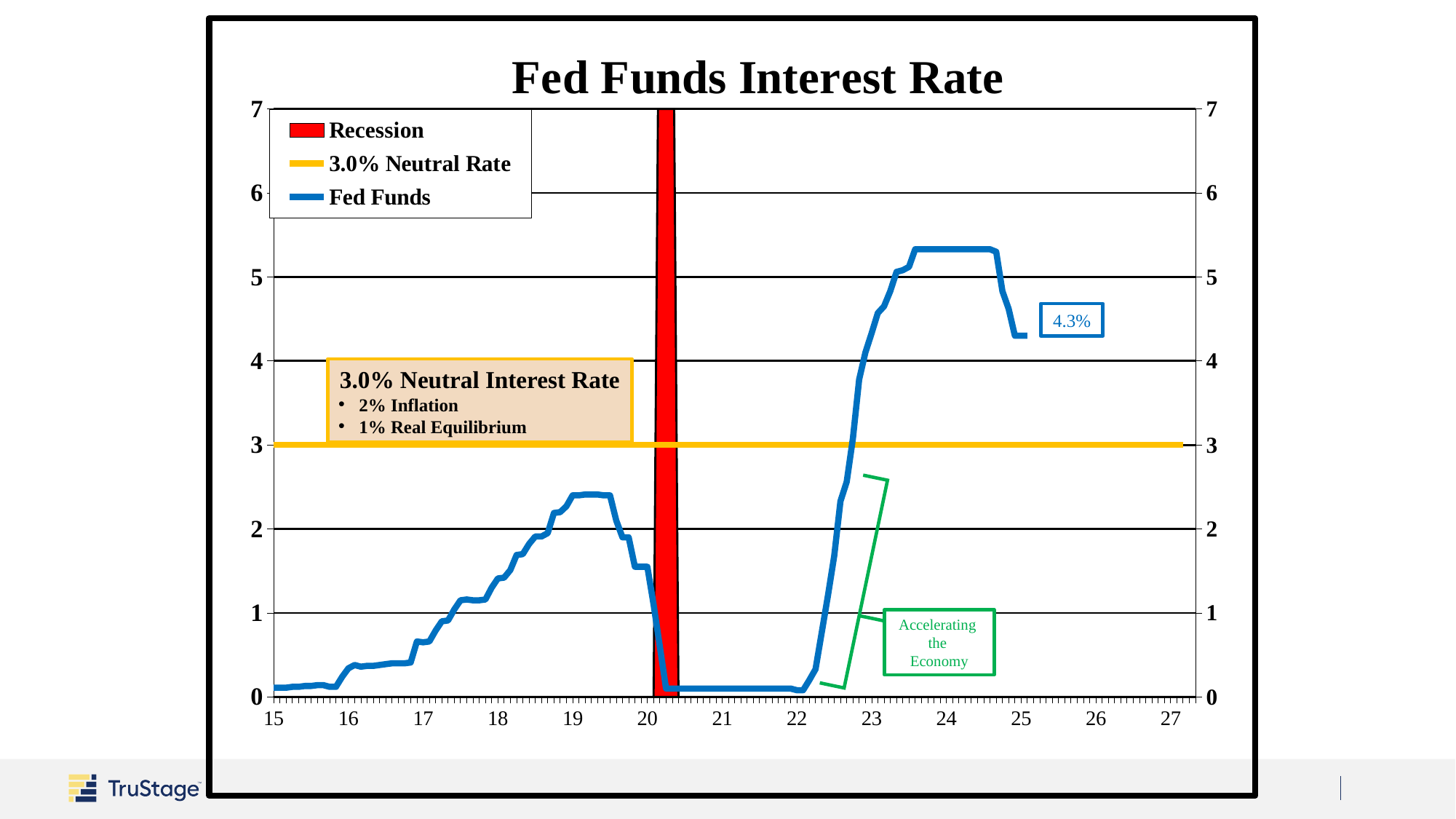
What is the labeled value of the Fed Funds rate at the end of the line, around 25? 4.3% What value is the neutral interest rate line drawn at? 3.0% Which is higher, the Fed Funds rate at 24 or the Fed Funds rate at 19? 24 By how much does the labeled 4.3% Fed Funds rate exceed the 3.0% neutral rate? 1.3% Is the Fed Funds rate at 24 greater or less than 5? greater Is the Fed Funds rate at 21 greater or less than 1? less How many entries does the chart legend list? 3 Is the Fed Funds rate at 19 greater or less than 3? less What does the red shaded area on the chart represent? Recession Does the Fed Funds rate rise or fall between 22 and 23? rise What is the title of the chart? Fed Funds Interest Rate What kind of chart is shown on the slide? line chart